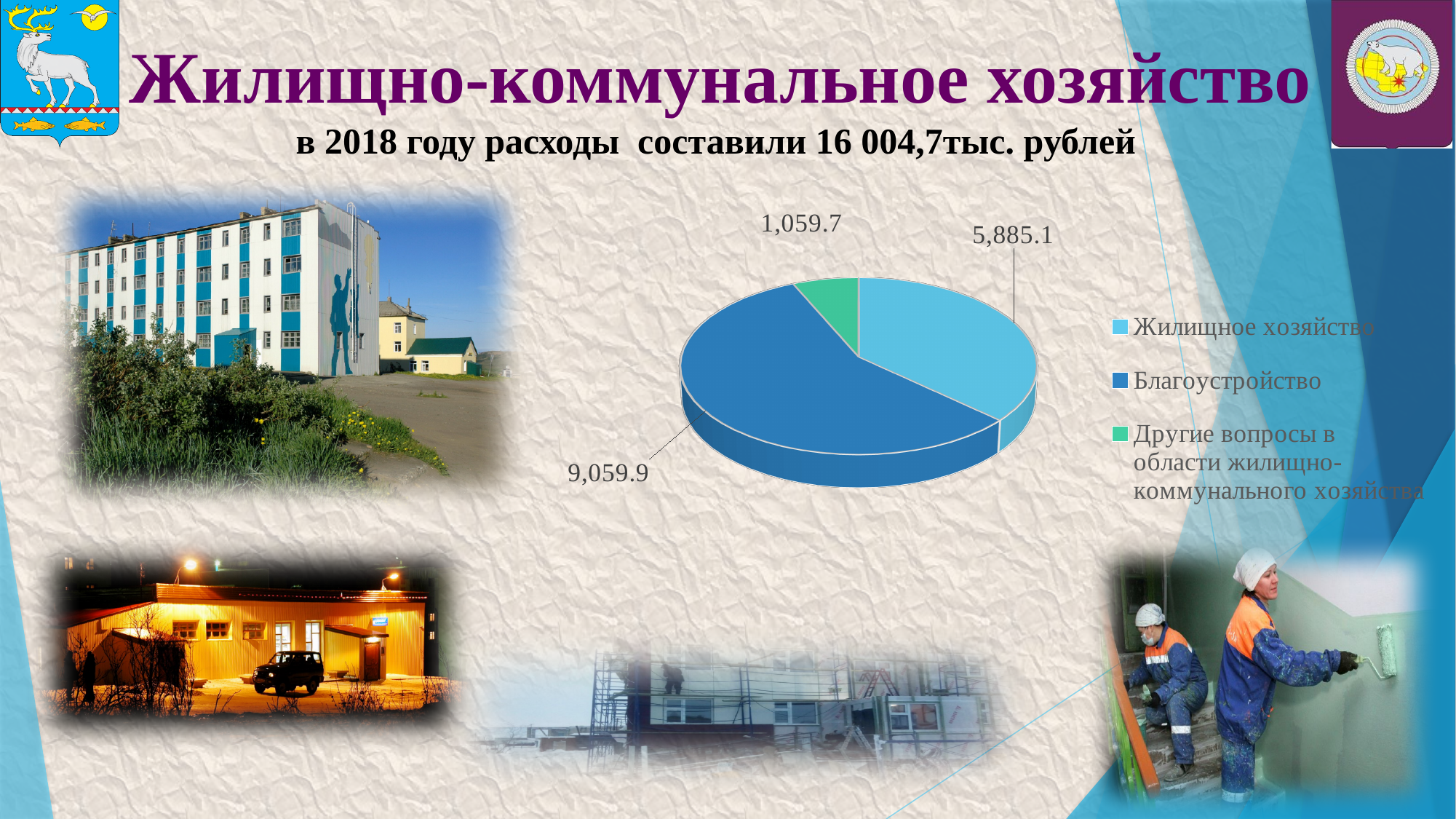
What is the total of all three slices in the pie chart? 16,004.7 What colour is the slice for Другие вопросы в области жилищно-коммунального хозяйства? Green What kind of chart is shown on the slide? Pie chart What is the value for Благоустройство? 9,059.9 What is the value for Другие вопросы в области жилищно-коммунального хозяйства? 1,059.7 What is the difference between the values for Жилищное хозяйство and Другие вопросы в области жилищно-коммунального хозяйства? 4,825.4 What is the value for Жилищное хозяйство? 5,885.1 Which is larger, the value for Жилищное хозяйство or the value for Благоустройство? Благоустройство What is the difference between the values for Благоустройство and Жилищное хозяйство? 3,174.8 Which category has the largest slice of the pie? Благоустройство How many slices does the pie chart have? 3 Which category has the smallest slice of the pie? Другие вопросы в области жилищно-коммунального хозяйства